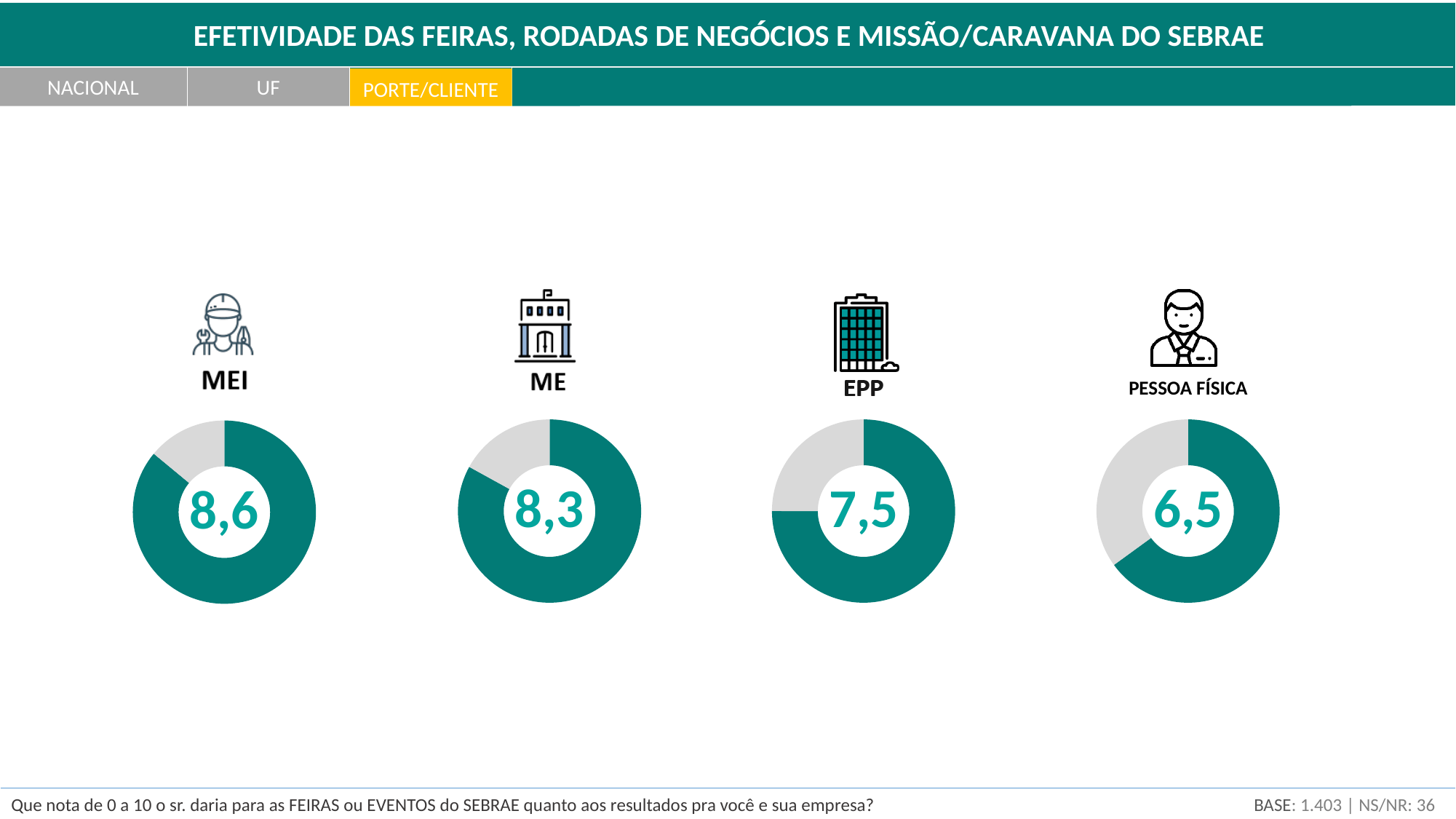
What kind of chart is used to display each group's score? Donut chart What score is shown in the ME donut chart? 8,3 What is the difference between the ME score and the EPP score? 0,8 What score is shown in the MEI donut chart? 8,6 What score is shown in the PESSOA FÍSICA donut chart? 6,5 What score is shown in the EPP donut chart? 7,5 Which has a higher score, EPP or PESSOA FÍSICA? EPP Which group has the highest score among the four donut charts? MEI How many donut charts are shown on the slide? 4 What is the difference between the MEI score and the PESSOA FÍSICA score? 2,1 Which tab is highlighted in yellow above the charts? PORTE/CLIENTE Which group has the lowest score among the four donut charts? PESSOA FÍSICA